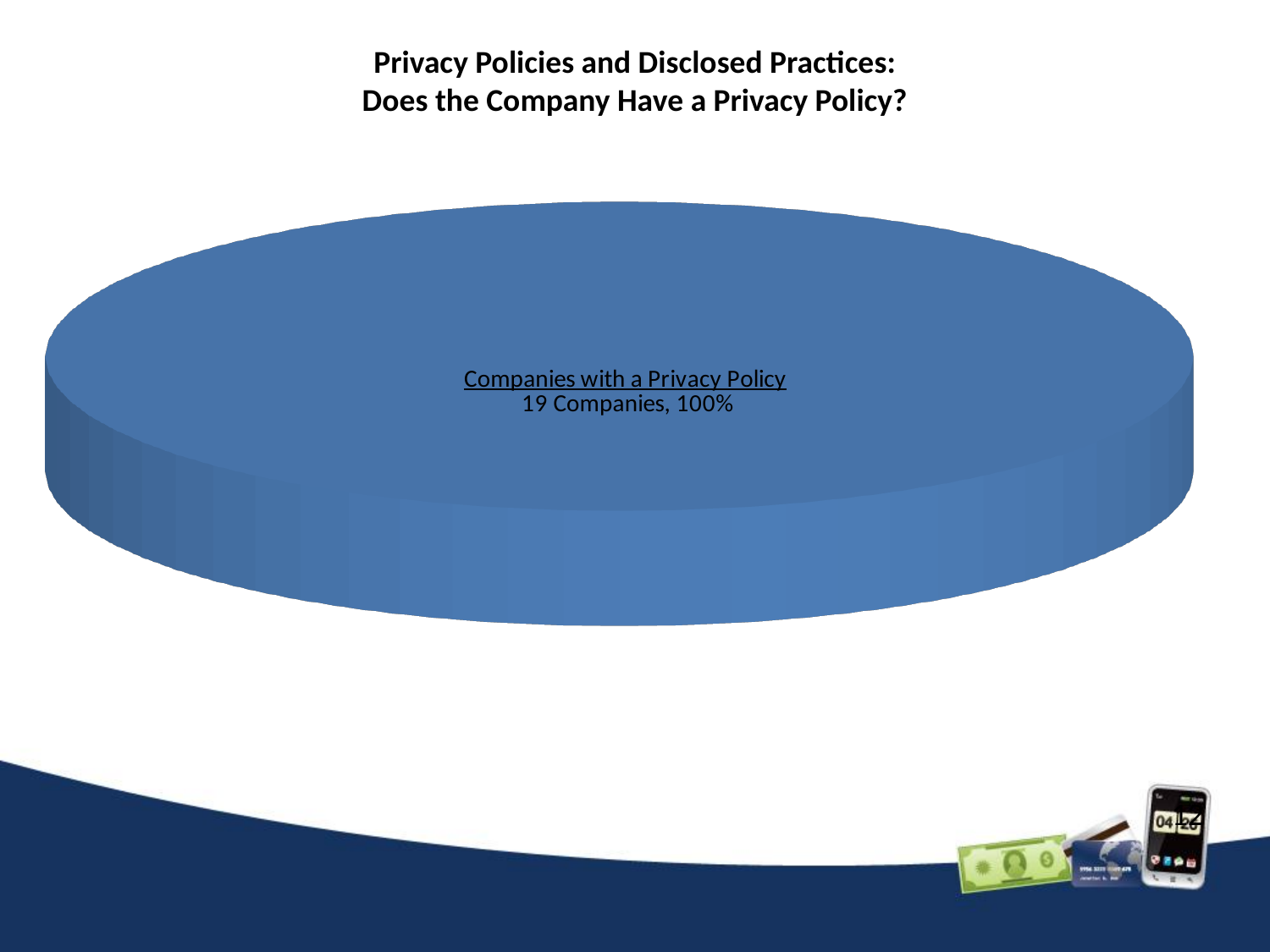
What is the title of the slide containing the pie chart? Privacy Policies and Disclosed Practices: Does the Company Have a Privacy Policy? How many slices does the pie chart have? 1 How many companies are in the "Companies with a Privacy Policy" slice? 19 Companies What kind of chart is shown on the slide? Pie chart What is the label of the only slice in the pie chart? Companies with a Privacy Policy Is the share for "Companies with a Privacy Policy" greater or less than 50%? greater What share of the pie does the "Companies with a Privacy Policy" slice represent? 100%